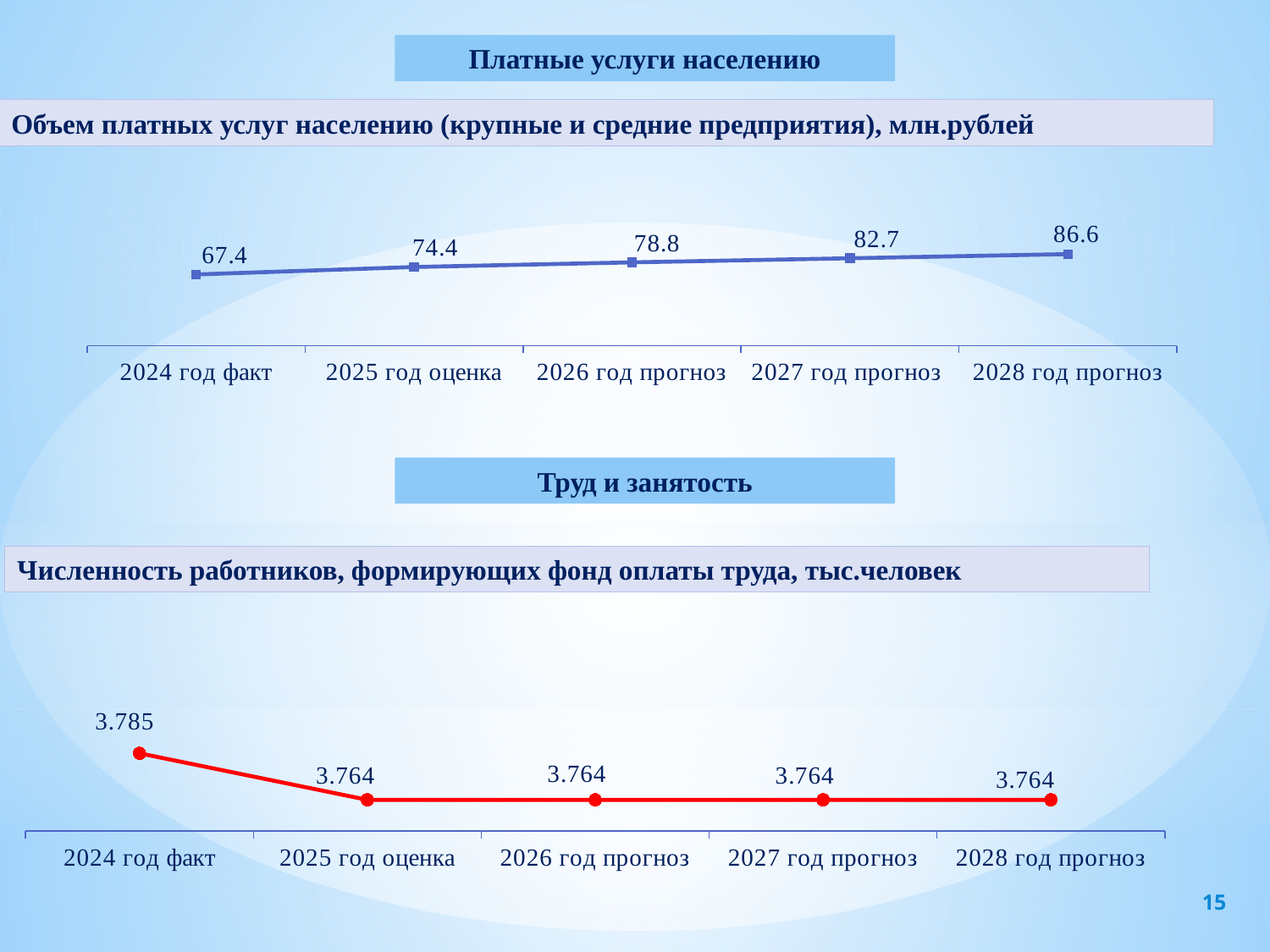
In the top chart (Объем платных услуг населению), what is the value for 2024 год факт? 67.4 In the top chart (Объем платных услуг населению), what is the difference between the values for 2028 год прогноз and 2024 год факт? 19.2 In the top chart (Объем платных услуг населению), which year has the lowest value? 2024 год факт In the top chart (Объем платных услуг населению), do the values rise or fall from 2024 to 2028? rise In the bottom chart (Численность работников), which is larger: the value for 2024 год факт or 2025 год оценка? 2024 год факт In the top chart (Объем платных услуг населению), which year has the highest value? 2028 год прогноз In the bottom chart (Численность работников), what is the value for 2024 год факт? 3.785 In the bottom chart (Численность работников), what is the value for 2027 год прогноз? 3.764 What type of chart is the bottom chart (Численность работников)? line chart In the top chart (Объем платных услуг населению), what is the value for 2026 год прогноз? 78.8 In the bottom chart (Численность работников), what is the difference between the values for 2024 год факт and 2025 год оценка? 0.021 In the top chart (Объем платных услуг населению), how many data points are plotted? 5